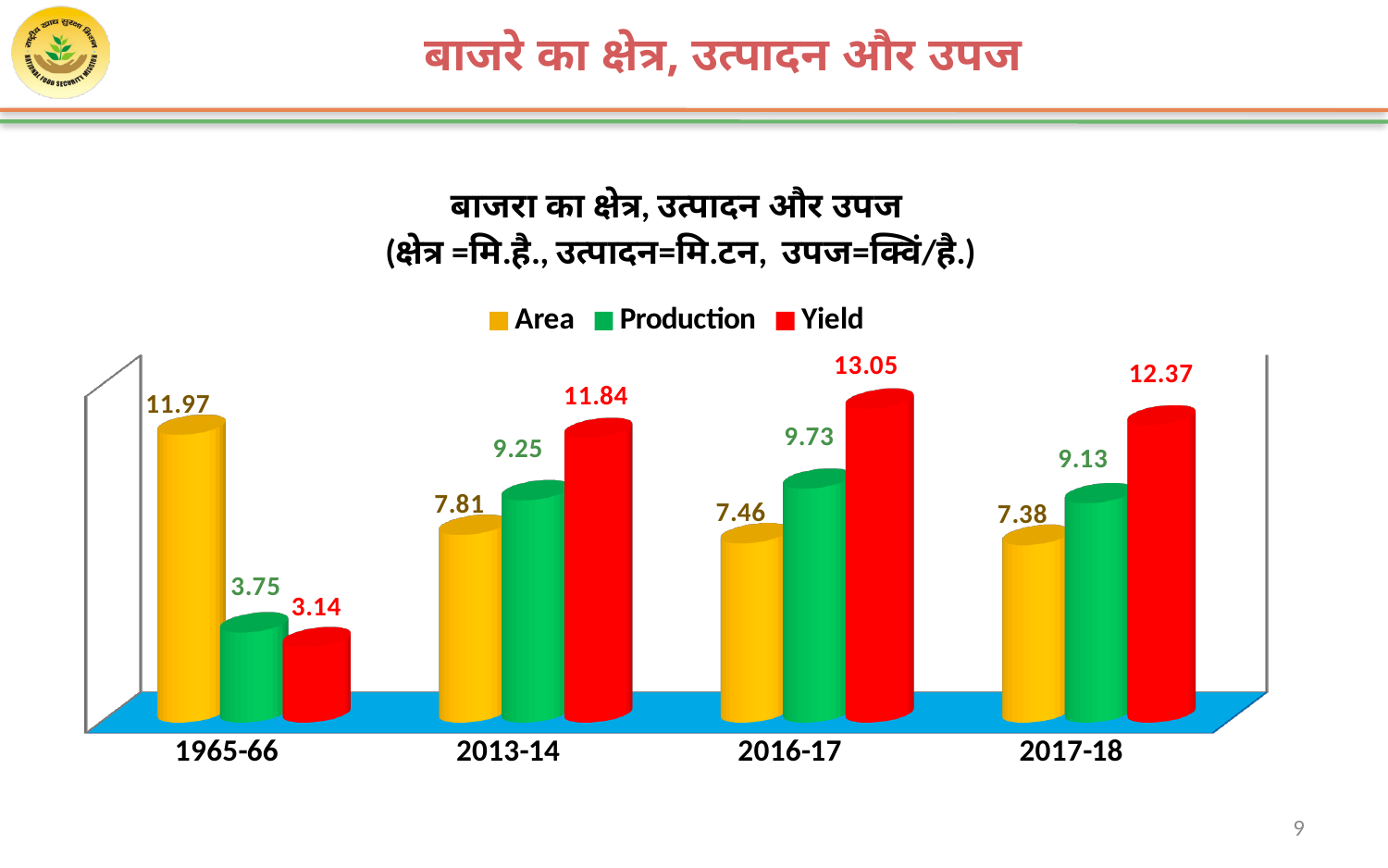
What is the Area value for 1965-66? 11.97 What is the Production value for 2013-14? 9.25 Which year has the lowest Production value? 1965-66 Which colour represents the Yield series in the legend? Red How many series does the legend list? 3 What kind of chart is shown on the slide? Bar chart What is the difference between the Yield values for 2016-17 and 2017-18? 0.68 What is the Yield value for 2016-17? 13.05 Does the Area value rise or fall from 1965-66 to 2017-18? Fall Which year has the highest Yield value? 2016-17 Which is larger, the Area value for 2013-14 or the Area value for 2017-18? 2013-14 How many years are shown on the x axis? 4